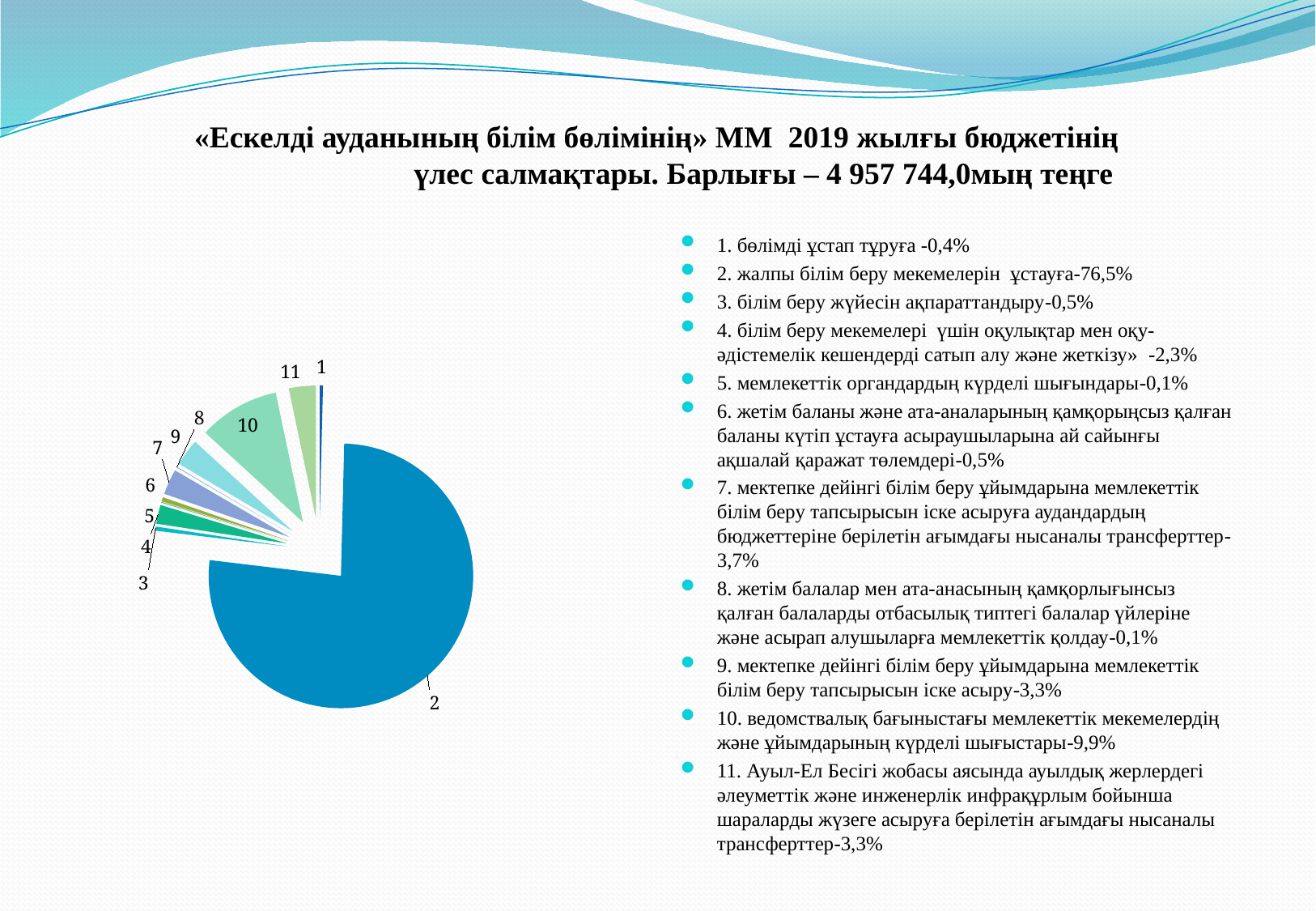
Which year's budget does the chart describe, according to the title? 2019 What share of the budget does slice 10 (ведомствалық бағыныстағы мемлекеттік мекемелердің және ұйымдарының күрделі шығыстары) represent? 9,9% Which slice is larger, slice 10 or slice 7? 10 What share of the budget does slice 4 (оқулықтар мен оқу-әдістемелік кешендерді сатып алу және жеткізу) represent? 2,3% According to the slide title, what is the total budget amount? 4 957 744,0 мың теңге Which slice is larger, slice 2 or slice 11? 2 What kind of chart is shown on the slide? pie chart What share of the budget does slice 2 (жалпы білім беру мекемелерін ұстауға) represent? 76,5% What share of the budget does slice 7 (мектепке дейінгі білім беру ұйымдарына ... ағымдағы нысаналы трансферттер) represent? 3,7% What is the difference in share between slice 2 and slice 10? 66,6% How many slices does the pie chart have? 11 Which slice of the pie chart is the largest? 2